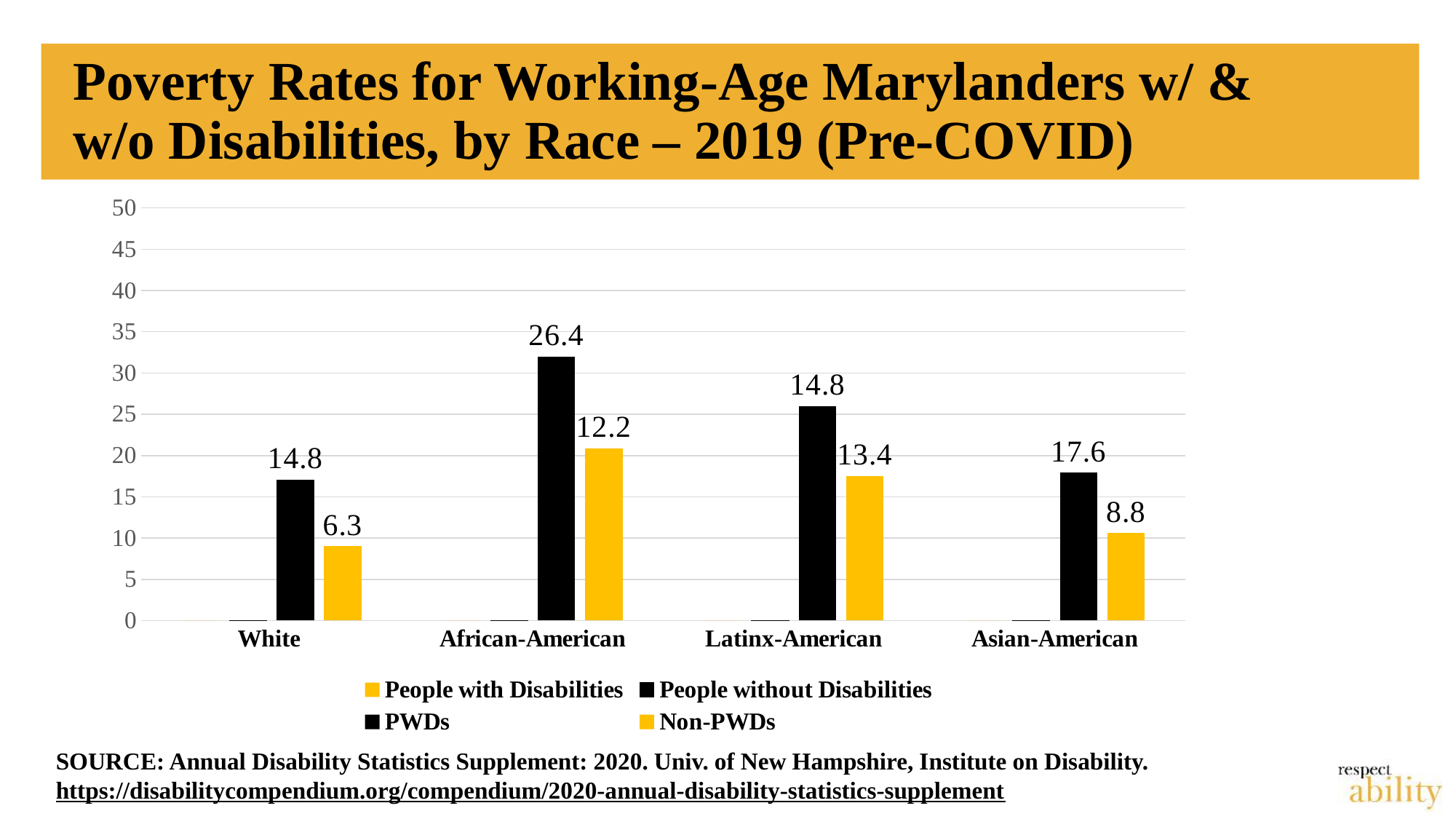
What is the title of the chart? Poverty Rates for Working-Age Marylanders w/ & w/o Disabilities, by Race – 2019 (Pre-COVID) How many entries does the legend list? 4 Which race category has the highest labelled value on its black bar? African-American What value is labelled on the black bar for Asian-American? 17.6 What value is labelled on the black bar for African-American? 26.4 How many race categories are shown on the x axis? 4 What value is labelled on the yellow bar for White? 6.3 For African-American, what is the difference between the black bar value and the yellow bar value? 14.2 For White, which is larger: the black bar value or the yellow bar value? the black bar (14.8) What kind of chart is shown on the slide? bar chart What value is labelled on the yellow bar for Latinx-American? 13.4 Which race category has the lowest labelled value on its yellow bar? White